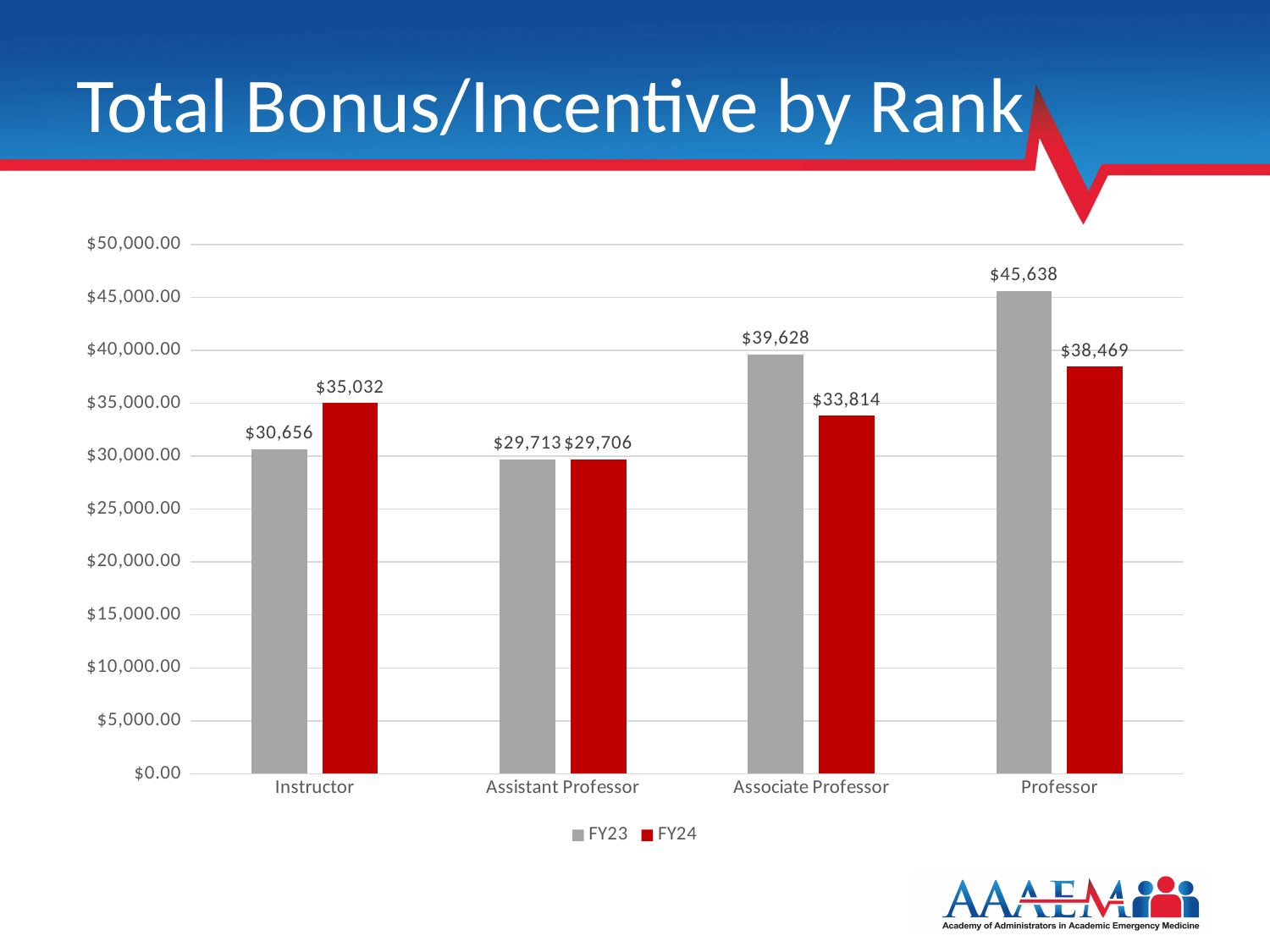
How many ranks are shown on the x axis? 4 What is the FY24 total bonus/incentive for Instructor? $35,032 What is the difference between the FY23 and FY24 values for Professor? $7,169 How many series does the legend list? 2 What kind of chart is shown on the slide? bar chart Which rank has the highest FY23 total bonus/incentive? Professor Is the FY24 value for Professor greater or less than $40,000.00? less What is the difference between the FY24 and FY23 values for Instructor? $4,376 Which rank has the lowest FY24 total bonus/incentive? Assistant Professor What is the FY23 total bonus/incentive for Associate Professor? $39,628 What is the FY23 value for Professor? $45,638 Which is larger for Associate Professor, the FY23 value or the FY24 value? FY23